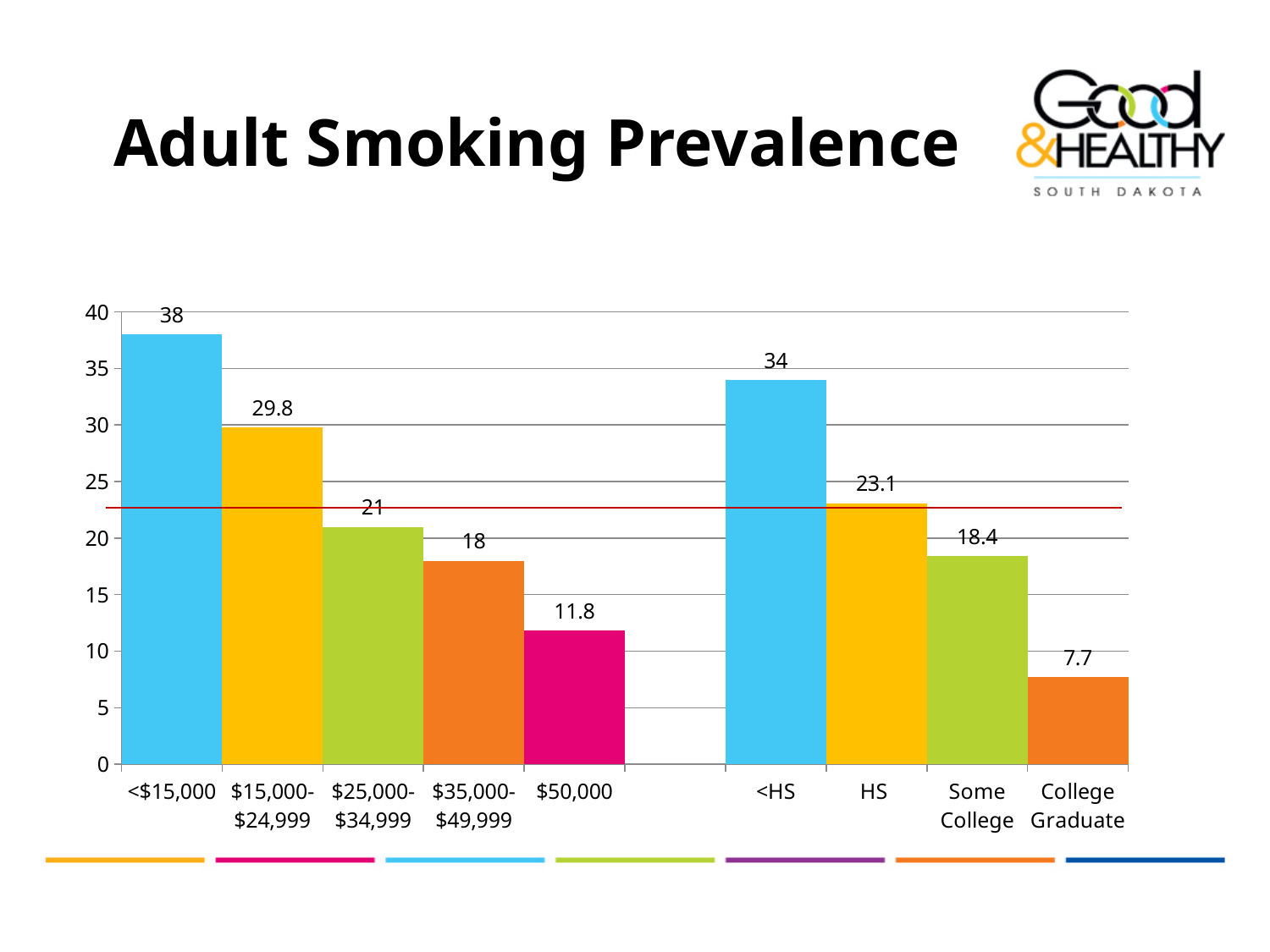
What is the difference between the values for <$15,000 and $50,000? 26.2 What is the value shown for the HS category? 23.1 Which category has the highest value on the chart? <$15,000 Which is larger, the value for $25,000-$34,999 or the value for Some College? $25,000-$34,999 What is the adult smoking prevalence value for the <$15,000 income category? 38 What is the value shown for the College Graduate category? 7.7 Which category has the lowest value on the chart? College Graduate How many bars are plotted on the chart? 9 What is the value shown for the $15,000-$24,999 income category? 29.8 What kind of chart is shown on the slide? bar chart What is the difference between the values for <HS and College Graduate? 26.3 Is the value for $35,000-$49,999 greater or less than 20? less